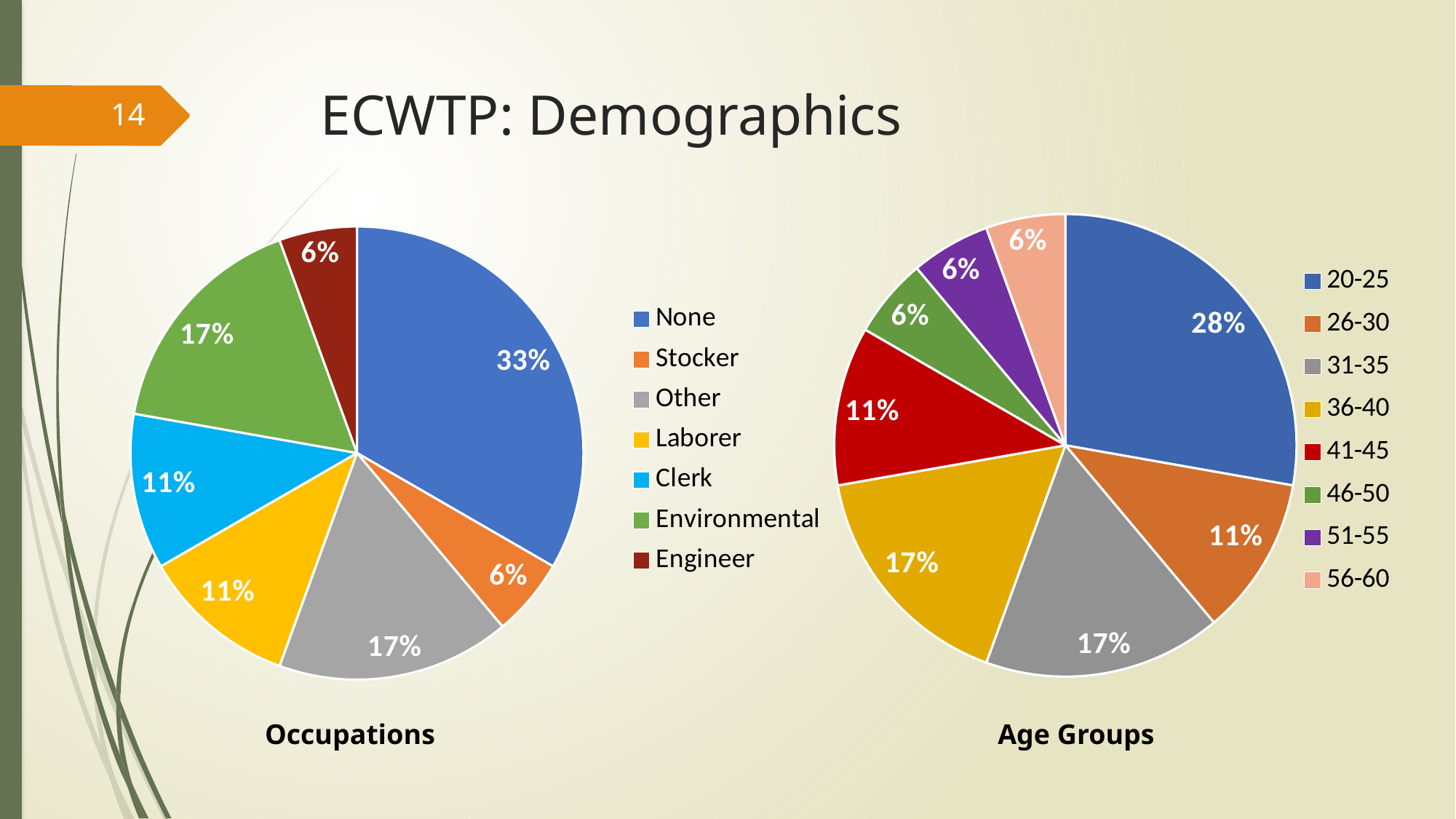
In the Occupations chart, how many categories does the legend list? 7 In the Occupations chart, which occupation has the largest slice? None In the Occupations chart, what share of the pie is None? 33% In the Age Groups chart, how many age groups does the legend list? 8 What kind of chart is the Age Groups chart? Pie chart In the Age Groups chart, what is the difference between the 20-25 slice and the 31-35 slice? 11% In the Age Groups chart, what percentage is labelled for 41-45? 11% In the Age Groups chart, what share of the pie is the 20-25 group? 28% In the Occupations chart, which is larger, Other or Laborer? Other In the Age Groups chart, which age group has the largest slice? 20-25 In the Occupations chart, what is the difference between the None slice and the Stocker slice? 27% In the Occupations chart, what percentage is labelled for Environmental? 17%